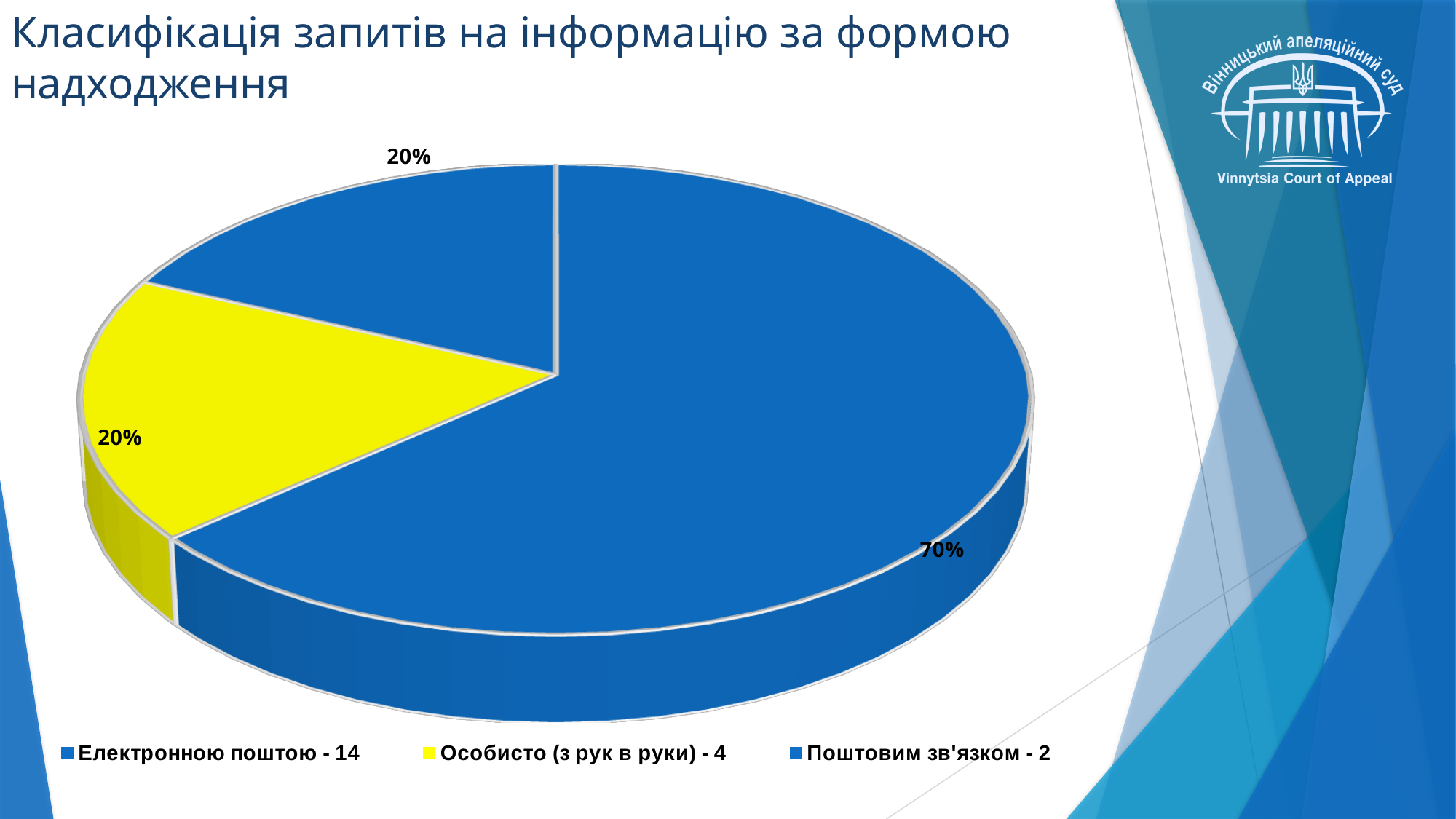
What is the value for Особисто (з рук в руки) according to the legend? 4 What is the value for Електронною поштою according to the legend? 14 What is the difference between the values for Електронною поштою and Особисто (з рук в руки)? 10 What kind of chart is shown on the slide? pie chart What share of the pie does the Особисто (з рук в руки) slice represent? 20% Which colour is used for the Особисто (з рук в руки) slice? yellow How many categories does the pie chart show? 3 What share of the pie does the Електронною поштою slice represent? 70% What is the value for Поштовим зв'язком according to the legend? 2 Which category has the largest slice of the pie? Електронною поштою How many entries does the legend list? 3